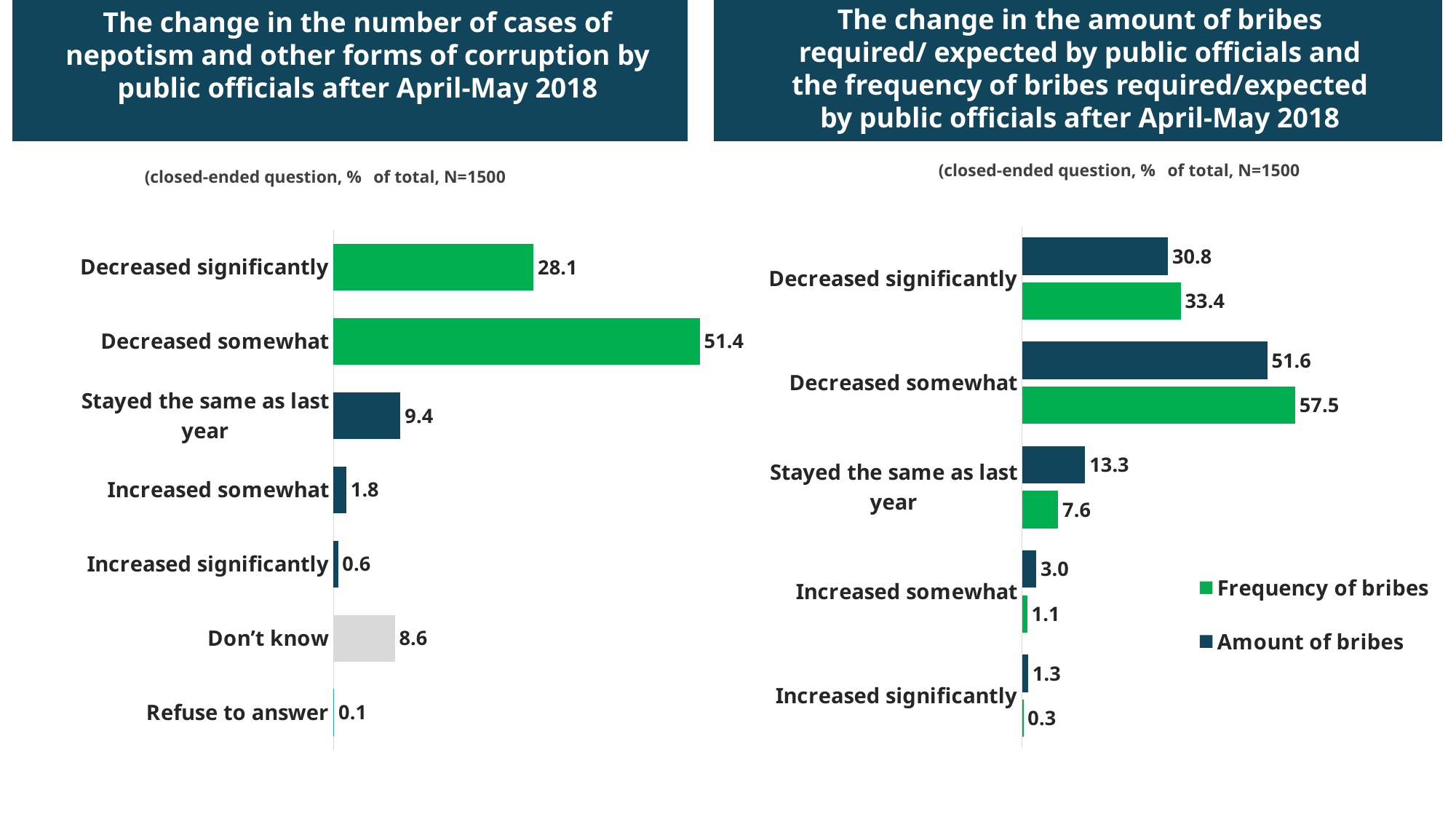
In the left chart on the change in the number of cases of nepotism, what is the value for "Decreased somewhat"? 51.4 In the left chart on the change in the number of cases of nepotism, which category has the highest value? Decreased somewhat In the right chart on the change in the amount and frequency of bribes, what is the difference between Frequency of bribes and Amount of bribes for "Decreased significantly"? 2.6 In the right chart on the change in the amount and frequency of bribes, which is larger for "Stayed the same as last year": Frequency of bribes or Amount of bribes? Amount of bribes In the left chart on the change in the number of cases of nepotism, what is the value for "Don't know"? 8.6 In the right chart on the change in the amount and frequency of bribes, what is the value of "Frequency of bribes" for "Decreased somewhat"? 57.5 In the left chart on the change in the number of cases of nepotism, which category has the lowest value? Refuse to answer What type of chart is the right chart on the change in the amount and frequency of bribes? Bar chart In the right chart on the change in the amount and frequency of bribes, what is the value of "Amount of bribes" for "Stayed the same as last year"? 13.3 In the left chart on the change in the number of cases of nepotism, what is the difference between "Decreased somewhat" and "Decreased significantly"? 23.3 How many series does the legend list in the right chart on the change in the amount and frequency of bribes? 2 How many categories are shown in the left chart on the change in the number of cases of nepotism? 7